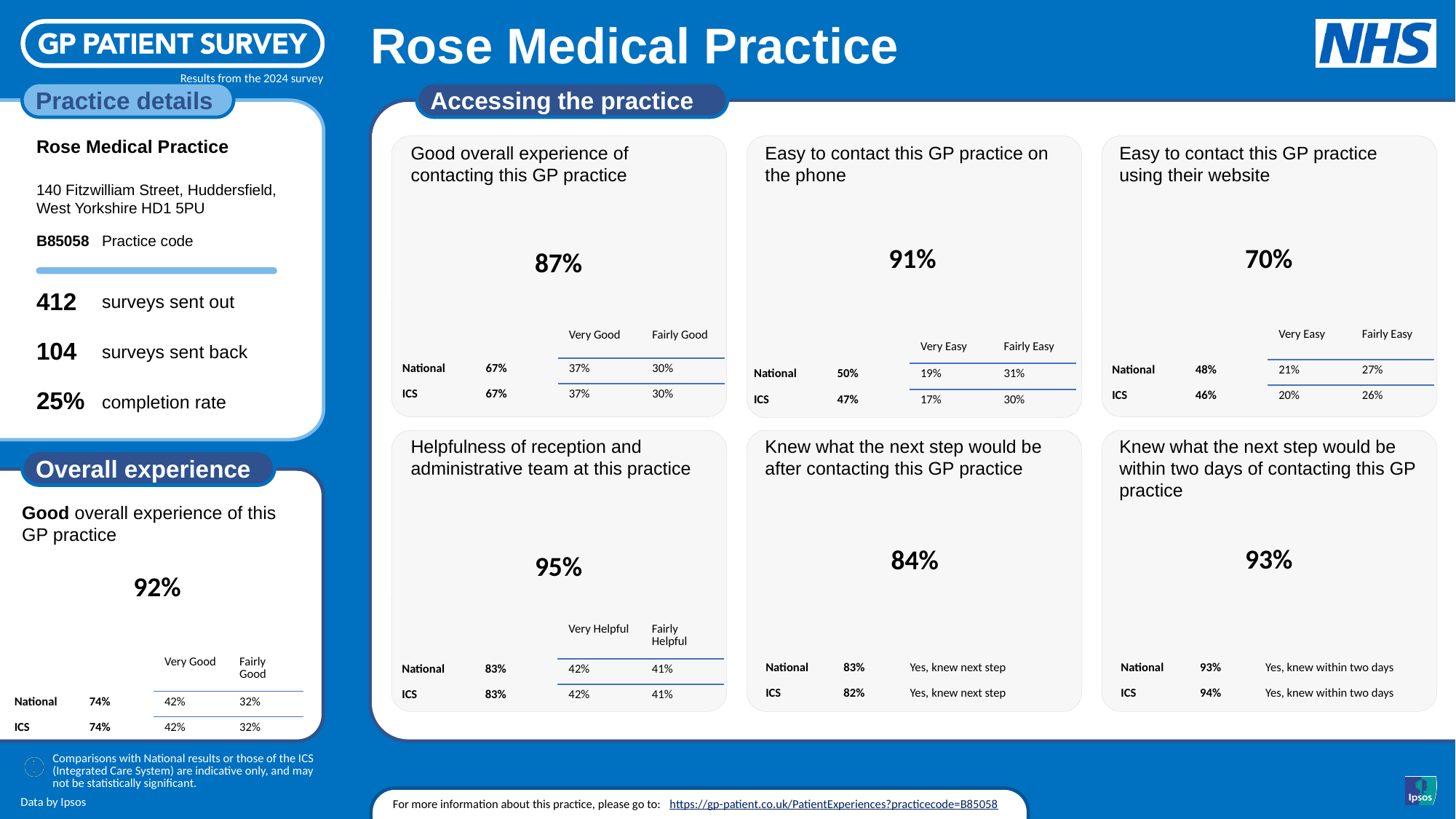
In the 'Good overall experience of contacting this GP practice' panel, what is the practice's headline percentage? 87% In the 'Knew what the next step would be within two days of contacting this GP practice' panel, which is larger, the National value or the ICS value? ICS In the 'Overall experience' panel, what is the practice's headline percentage for good overall experience of this GP practice? 92% In the 'Easy to contact this GP practice on the phone' panel, what is the difference between the practice's headline percentage and the National value? 41% In the 'Easy to contact this GP practice using their website' panel, what is the difference between the practice's headline percentage and the ICS value? 24% In the 'Easy to contact this GP practice using their website' panel, what is the National value? 48% In the 'Easy to contact this GP practice on the phone' panel, what is the practice's headline percentage? 91% Among the six 'Accessing the practice' panels, which has the highest headline percentage? Helpfulness of reception and administrative team at this practice In the 'Helpfulness of reception and administrative team at this practice' panel, what is the ICS value for Very Helpful? 42% In the 'Knew what the next step would be after contacting this GP practice' panel, what is the ICS value? 82% In the 'Overall experience' panel, what is the National value for Fairly Good? 32% Among the six 'Accessing the practice' panels, which has the lowest headline percentage? Easy to contact this GP practice using their website